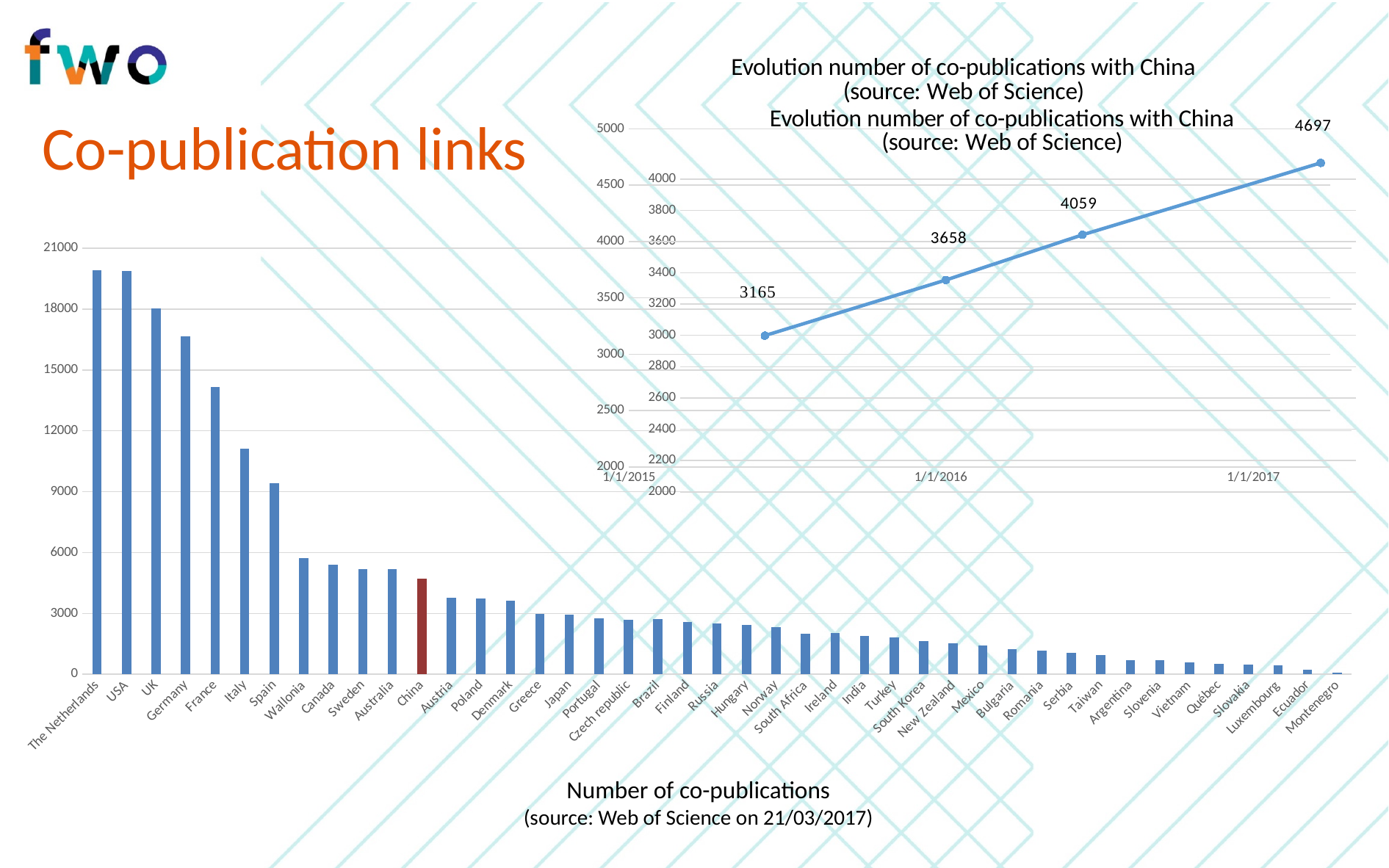
In the 'Evolution number of co-publications with China' chart, do the values rise or fall over time? rise In the 'Evolution number of co-publications with China' chart, what is the difference between the highest and lowest labelled values? 1532 In the 'Number of co-publications' chart, is the value for China greater or less than 6000? less In the 'Evolution number of co-publications with China' chart, what is the value of the first data point? 3165 In the 'Evolution number of co-publications with China' chart, how many data points are plotted? 4 What kind of chart is the 'Number of co-publications' chart? bar chart In the 'Evolution number of co-publications with China' chart, what is the value of the last data point? 4697 In the 'Number of co-publications' chart, which bar is coloured differently (red) from the others? China In the 'Evolution number of co-publications with China' chart, what is the value of the second data point? 3658 What kind of chart is the 'Evolution number of co-publications with China' chart? line chart In the 'Number of co-publications' chart, which country has the lowest value? Montenegro In the 'Number of co-publications' chart, is the value for Germany greater or less than 15000? greater